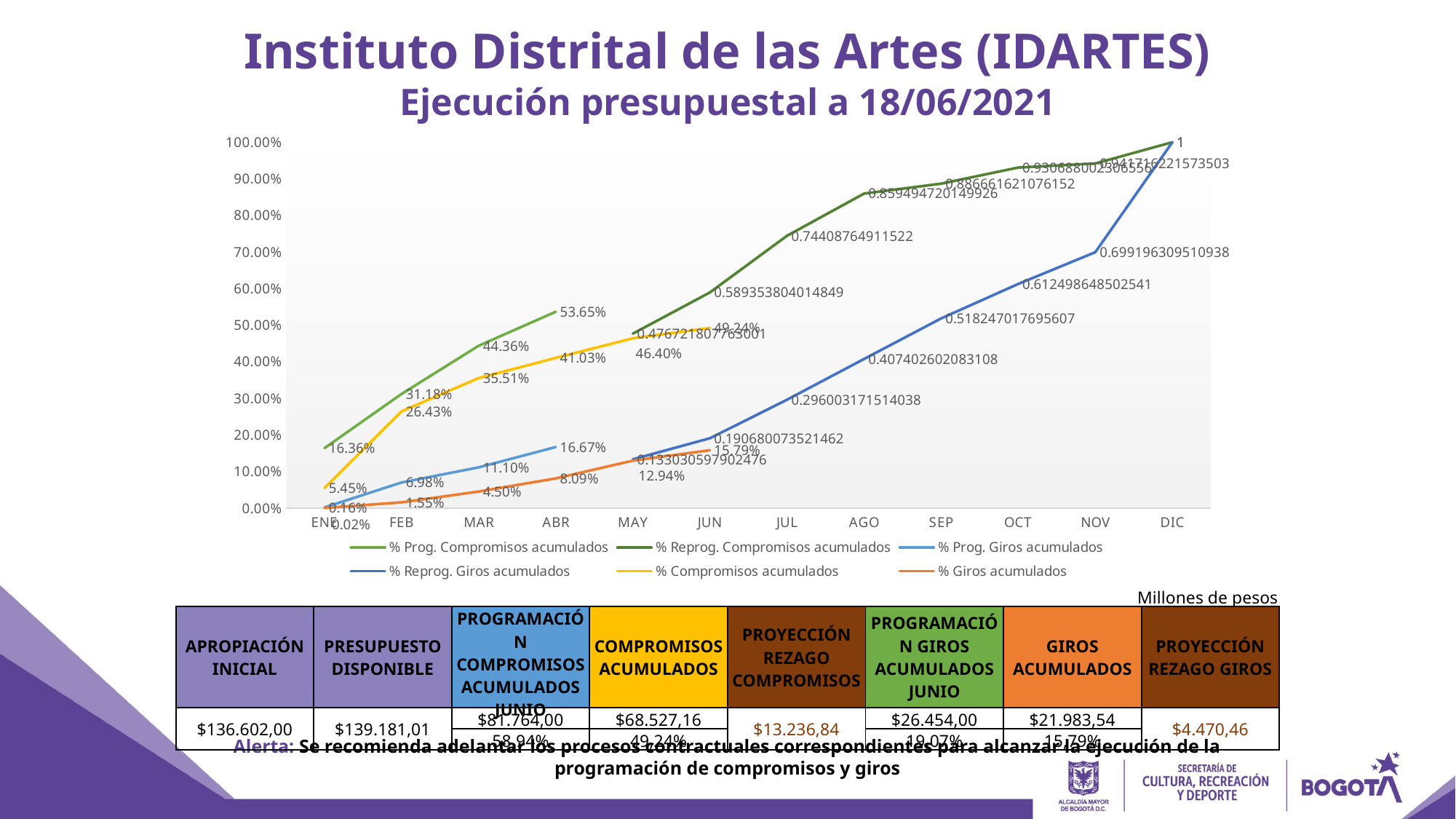
What is the value of % Prog. Giros acumulados in ABR? 16.67% In MAR, which is larger: % Prog. Compromisos acumulados or % Compromisos acumulados? % Prog. Compromisos acumulados What is the difference between % Prog. Compromisos acumulados and % Compromisos acumulados in ABR? 12.62% In which month does % Compromisos acumulados reach its highest value? JUN What is the value of % Prog. Compromisos acumulados in ABR? 53.65% What kind of chart is shown on the slide? line chart How many series does the chart legend list? 6 Does % Giros acumulados rise or fall from ENE to JUN? rise How many months are shown along the x axis of the chart? 12 What is the value of % Compromisos acumulados in JUN? 49.24% Is the value for % Reprog. Giros acumulados in NOV greater or less than 60.00%? greater What is the value of % Giros acumulados in JUN? 15.79%